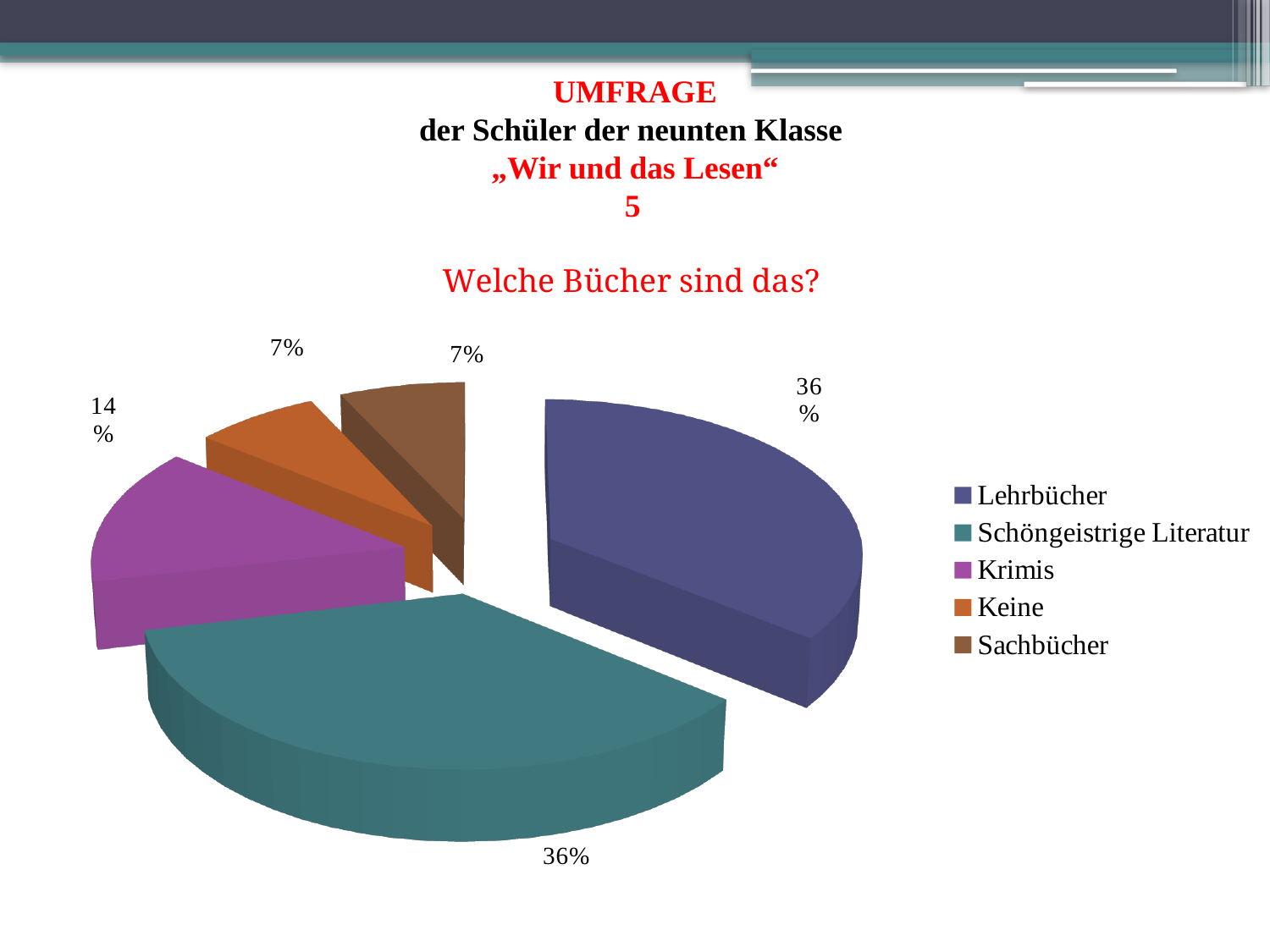
What percentage of the pie chart is Sachbücher? 7% What percentage of the pie chart is Schöngeistrige Literatur? 36% Which is larger in the pie chart, Krimis or Keine? Krimis What is the difference in percentage points between Lehrbücher and Krimis? 22 How many slices does the pie chart have? 5 What kind of chart is shown on the slide? Pie chart What percentage of the pie chart is Keine? 7% What is the difference in percentage points between Krimis and Sachbücher? 7 Which is larger in the pie chart, Lehrbücher or Sachbücher? Lehrbücher What is the title of the chart? Welche Bücher sind das? What percentage of the pie chart is Krimis? 14% What percentage of the pie chart is Lehrbücher? 36%